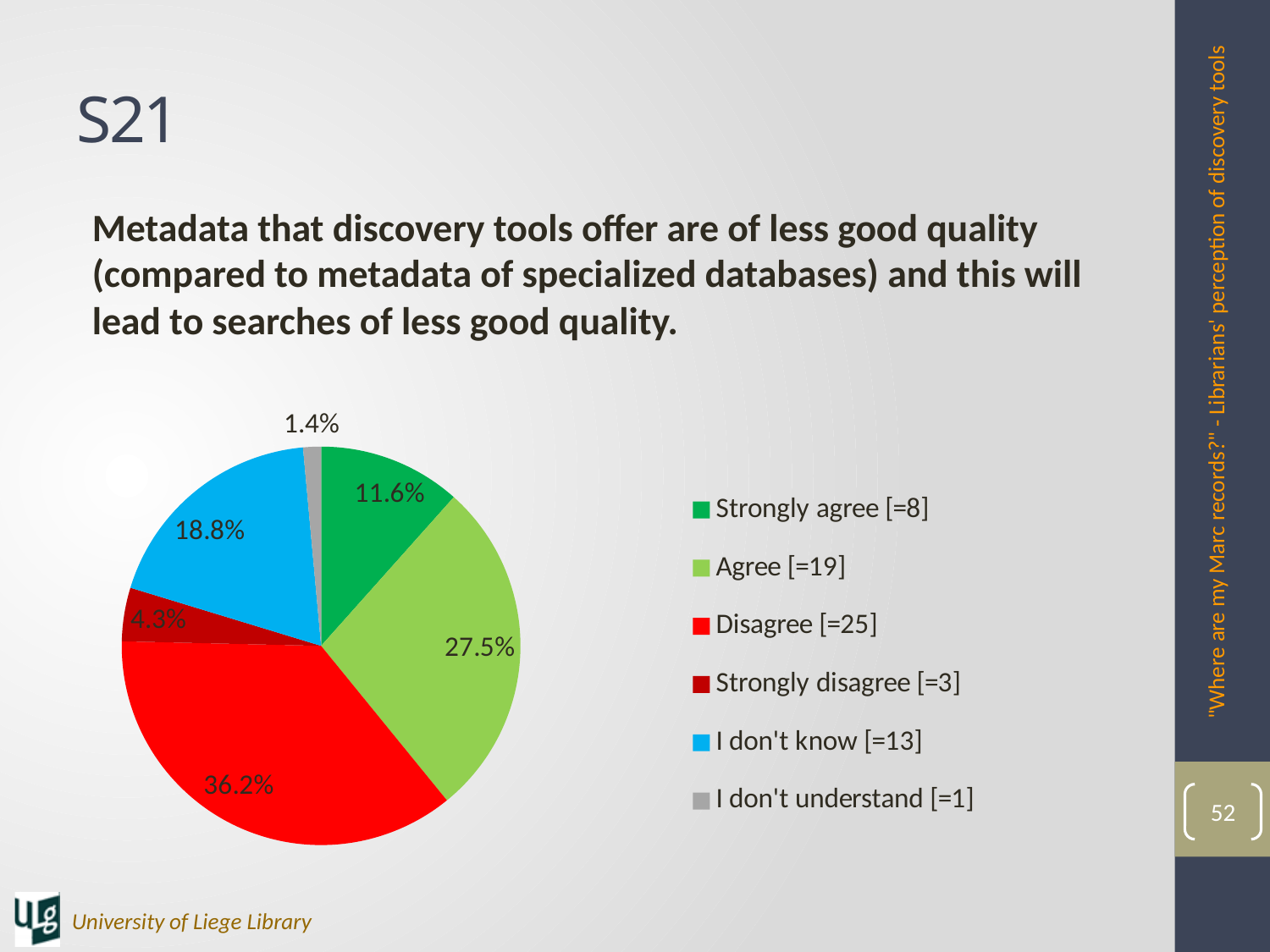
What is the difference in percentage points between the Disagree and Agree slices? 8.7 How many respondents chose Disagree according to the legend? 25 What percentage of the pie chart is the Disagree slice? 36.2% What percentage of the pie chart is the Agree slice? 27.5% What percentage of the pie chart is the I don't know slice? 18.8% How many respondents chose I don't understand according to the legend? 1 Which response category has the largest slice of the pie chart? Disagree How many categories does the pie chart legend list? 6 Which slice is larger, Strongly agree or I don't know? I don't know Which response category has the smallest slice of the pie chart? I don't understand